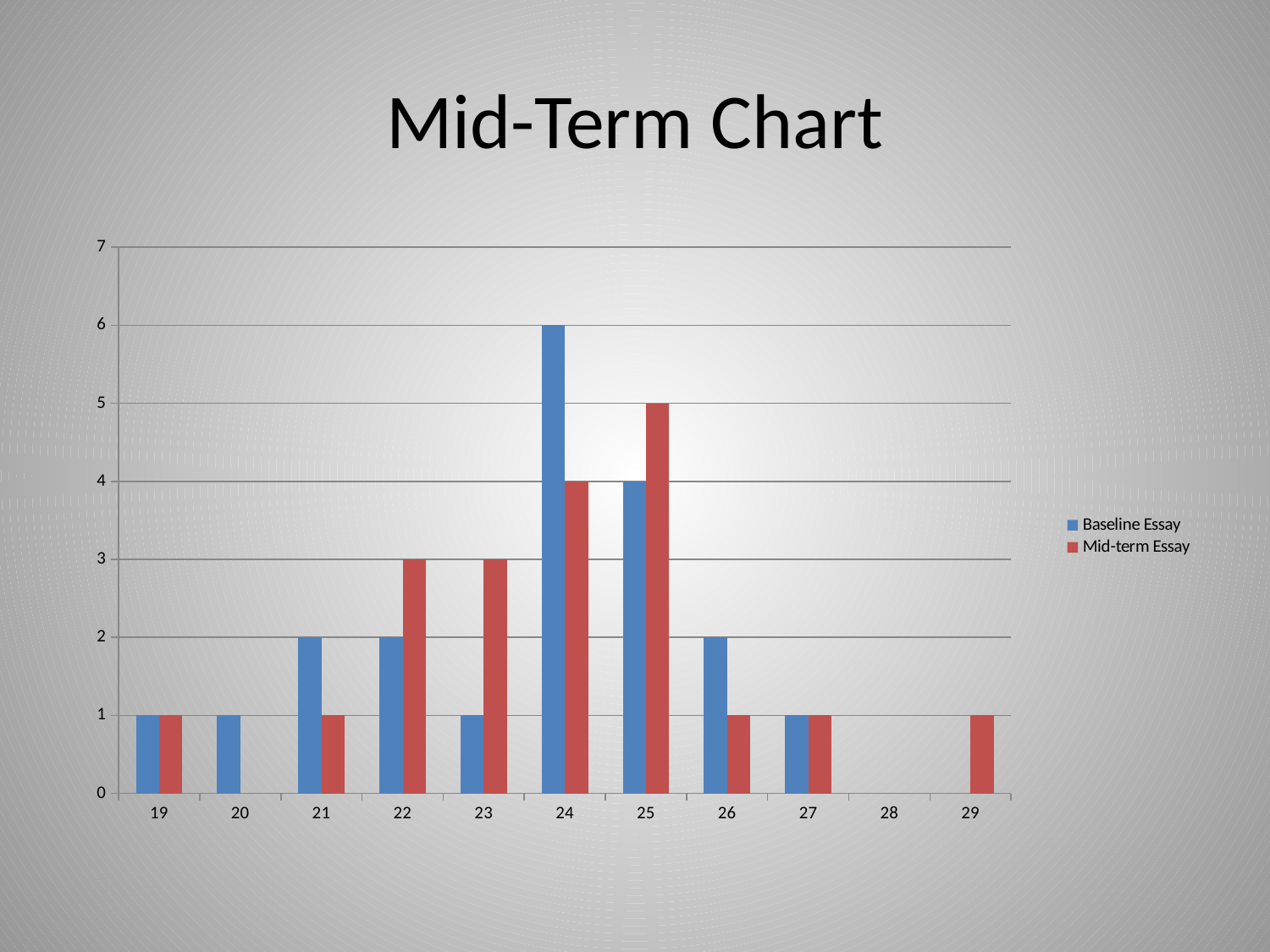
What is the Mid-term Essay value for category 22? 3 Which series is shown in red? Mid-term Essay What is the difference between the Baseline Essay and Mid-term Essay values for category 24? 2 What is the title of the chart? Mid-Term Chart For category 23, which series has the larger value, Baseline Essay or Mid-term Essay? Mid-term Essay What is the Baseline Essay value for category 24? 6 What is the Mid-term Essay value for category 25? 5 What kind of chart is shown on the slide? Bar chart How many categories are shown on the x axis? 11 How many series does the legend list? 2 Which category has the highest Baseline Essay value? 24 Which category has the highest Mid-term Essay value? 25